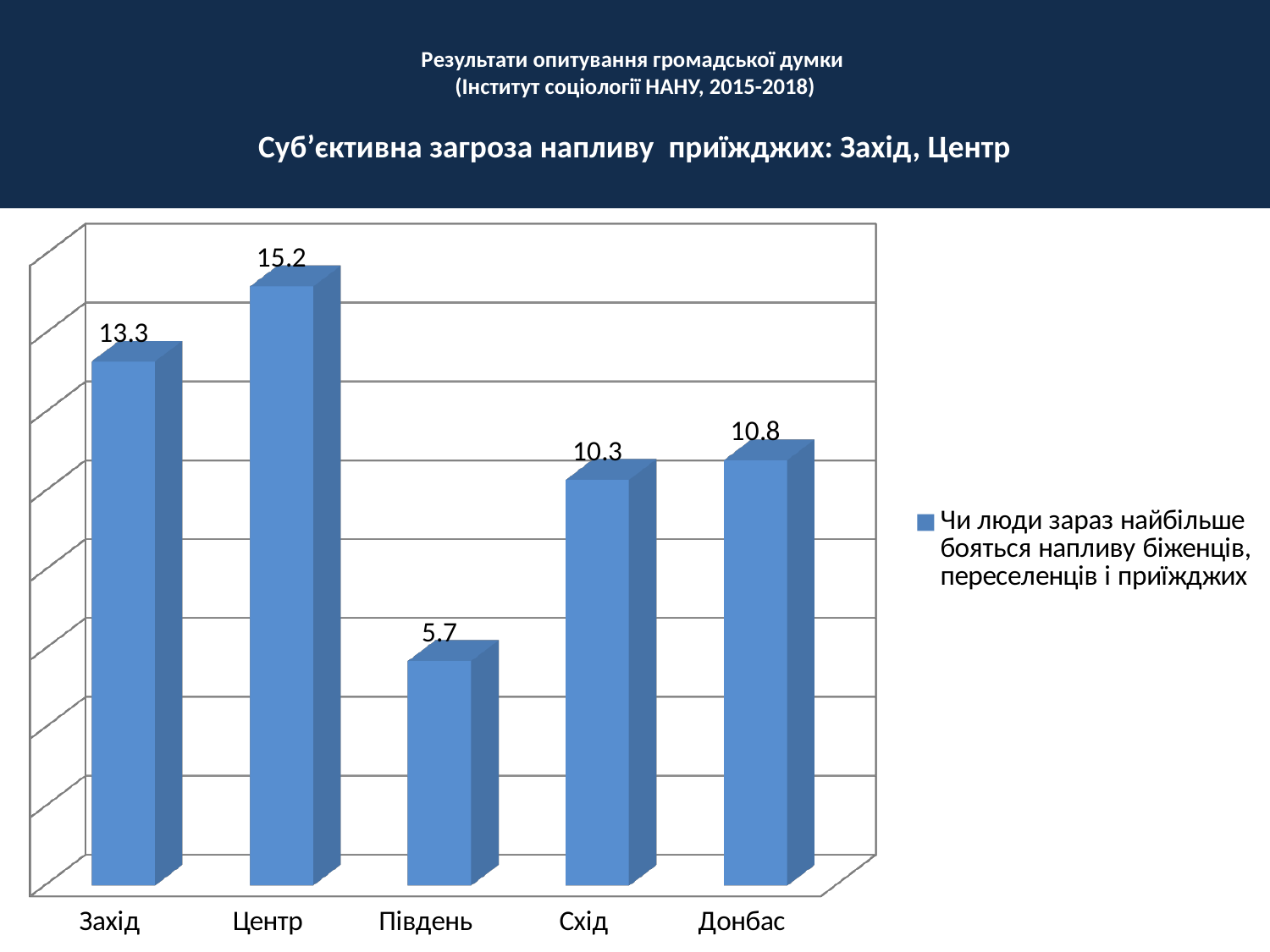
What is the difference between the values for Донбас and Схід? 0.5 Which category has the lowest value? Південь How many categories are shown on the x axis? 5 Which category has the highest value? Центр How many series does the legend list? 1 What is the difference between the values for Центр and Захід? 1.9 What is the value for Центр? 15.2 Which is larger, the value for Захід or the value for Схід? Захід What is the value for Південь? 5.7 What is the value for Донбас? 10.8 What kind of chart is shown on the slide? bar chart What is the value for Захід? 13.3